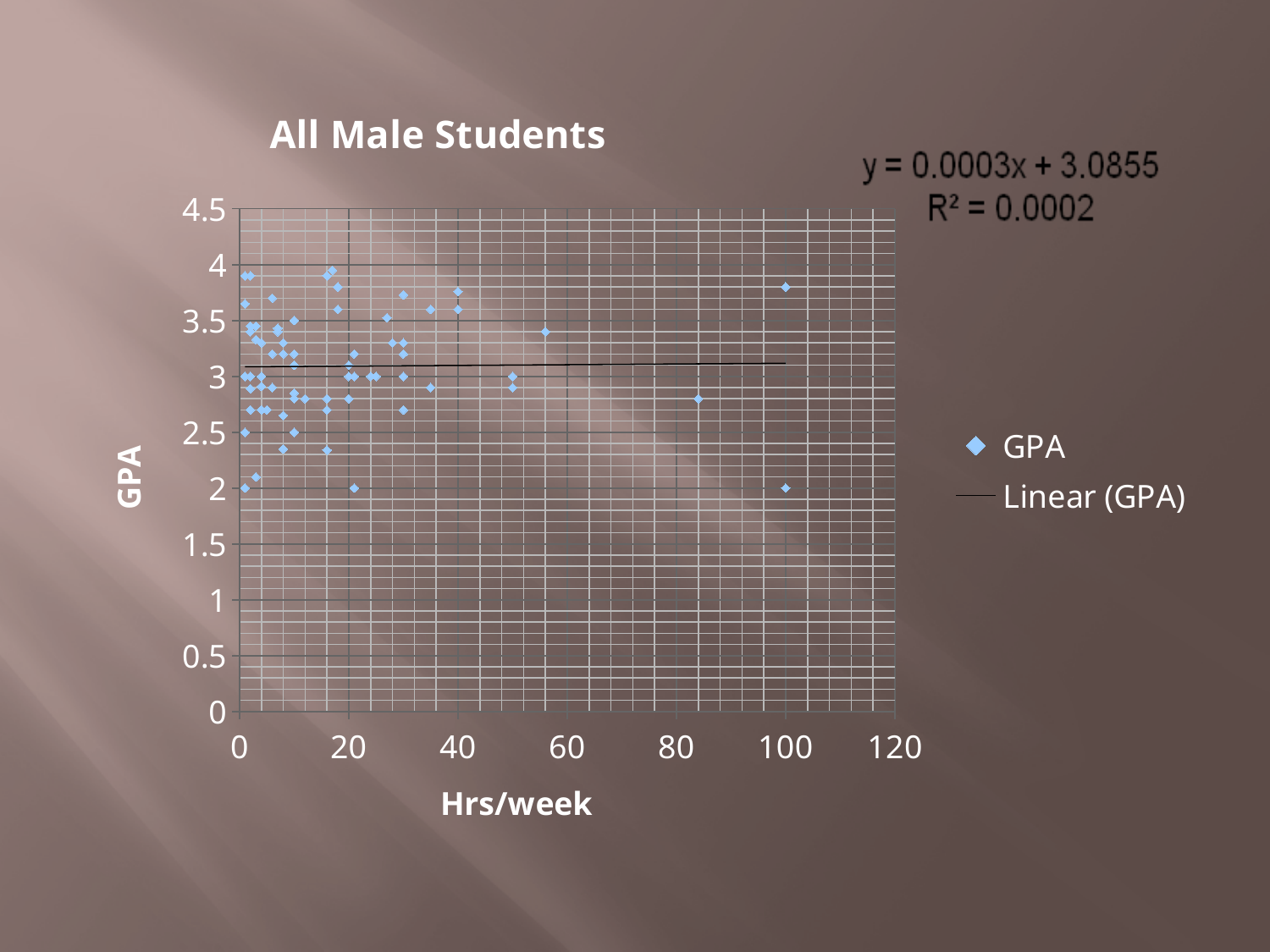
What is the maximum value shown on the x axis? 120 What is the label of the x axis? Hrs/week What kind of chart is shown on the slide? scatter chart What R² value is shown for the trendline? 0.0002 What is the equation of the trendline shown on the slide? y = 0.0003x + 3.0855 Is the GPA of the lower point plotted at 100 Hrs/week greater or less than 2.5? less How many series does the legend list? 2 What is the title of the chart? All Male Students Is the GPA of the higher point plotted at 100 Hrs/week greater or less than 3.5? greater What is the maximum value shown on the y axis? 4.5 Does the linear trendline rise steeply, fall, or stay nearly flat as Hrs/week increases? nearly flat Is the highest GPA plotted on the chart greater or less than 3.5? greater